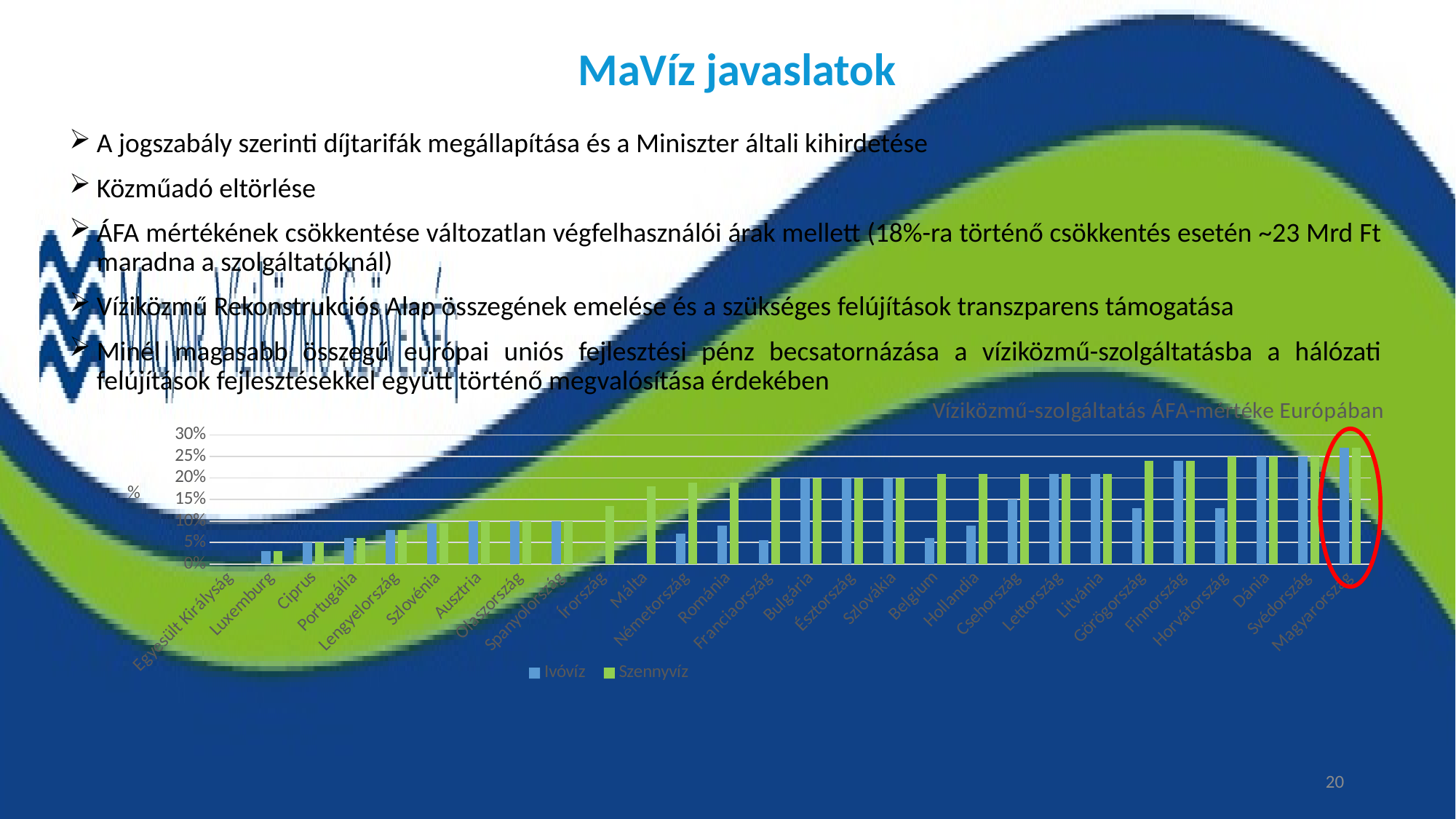
How many series does the chart's legend list? 2 For Csehország, which is larger: the Ivóvíz value or the Szennyvíz value? Szennyvíz Is the Ivóvíz value for Németország greater or less than 10%? less Which country has the highest Ivóvíz value in the chart? Magyarország Is the Szennyvíz value for Horvátország greater or less than 20%? greater How many countries are shown on the x axis of the chart? 28 What kind of chart is shown on the slide? bar chart Is the Ivóvíz value for Luxemburg greater or less than 5%? less What are the two series named in the chart's legend? Ivóvíz and Szennyvíz Do the values in the chart generally rise or fall from left to right along the x axis? rise What is the title of the chart on the slide? Víziközmű-szolgáltatás ÁFA-mértéke Európában